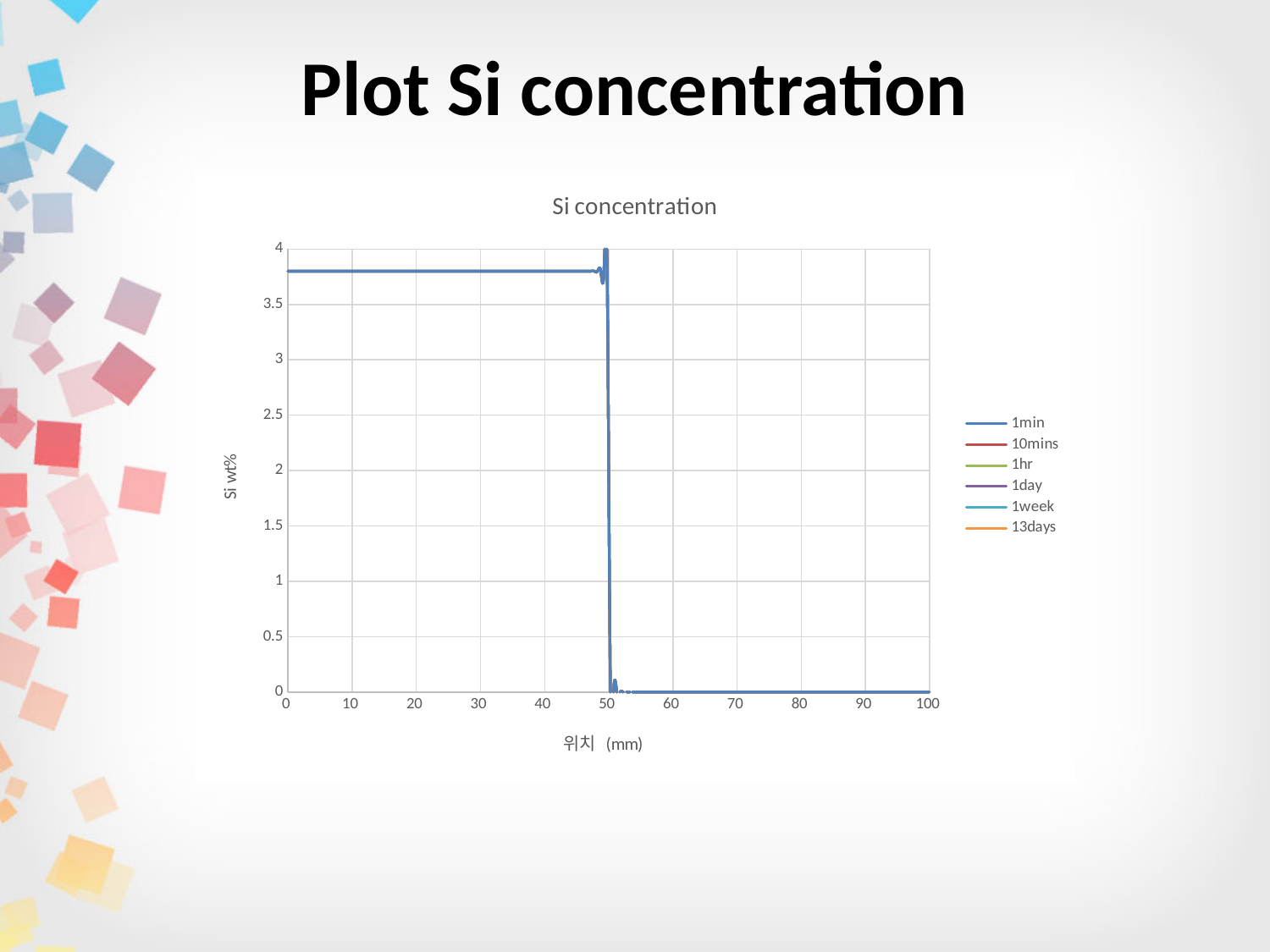
Is the Si concentration at position 30 mm greater or less than 3.5? greater What kind of chart is shown on the slide? line chart What is the highest tick value shown on the vertical axis? 4 Is the Si concentration at 10 mm larger or smaller than at 90 mm? larger How many series does the legend of the Si concentration chart list? 6 What is the title of the chart? Si concentration Is the Si concentration at position 70 mm greater or less than 0.5? less Is the Si concentration at position 20 mm greater or less than 3? greater What is the label of the vertical axis? Si wt% Do the plotted Si concentration values rise or fall as position increases from 0 to 100 mm? fall